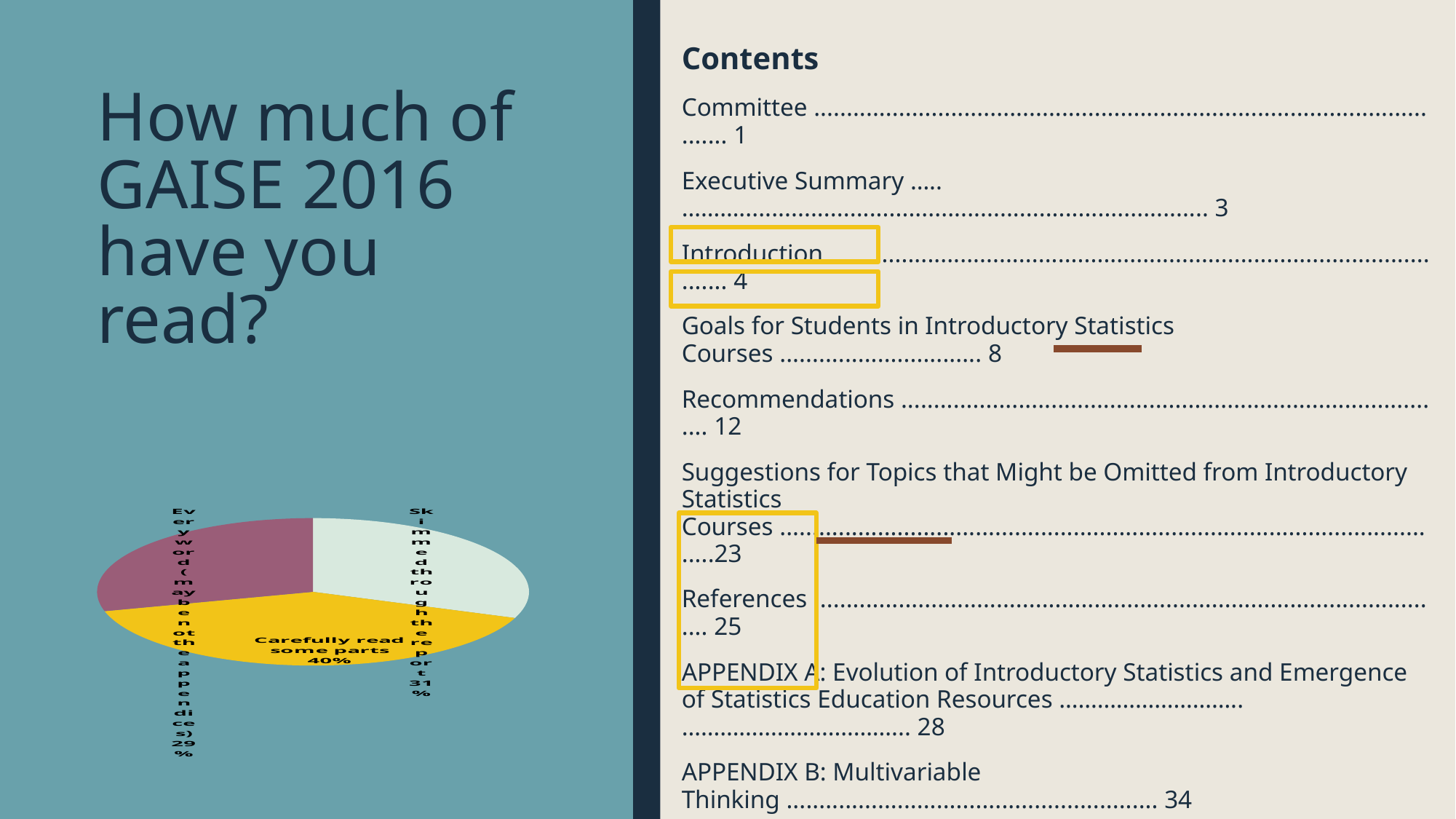
What share of the pie does the 'Carefully read some parts' slice represent? 40% How many percentage points larger is 'Carefully read some parts' than 'Every word (maybe not the appendices)'? 11 What percentage of respondents skimmed through the report? 31% How many percentage points larger is 'Carefully read some parts' than 'Skimmed through the report'? 9 What percentage of respondents carefully read some parts of GAISE 2016? 40% Which is larger: the share for 'Skimmed through the report' or for 'Every word (maybe not the appendices)'? Skimmed through the report How many slices does the pie chart have? 3 Which response has the smallest share of the pie? Every word (maybe not the appendices) What colour is the 'Carefully read some parts' slice of the pie chart? yellow Which response has the largest share of the pie? Carefully read some parts What kind of chart is shown on the slide? pie chart What percentage of respondents read every word (maybe not the appendices)? 29%